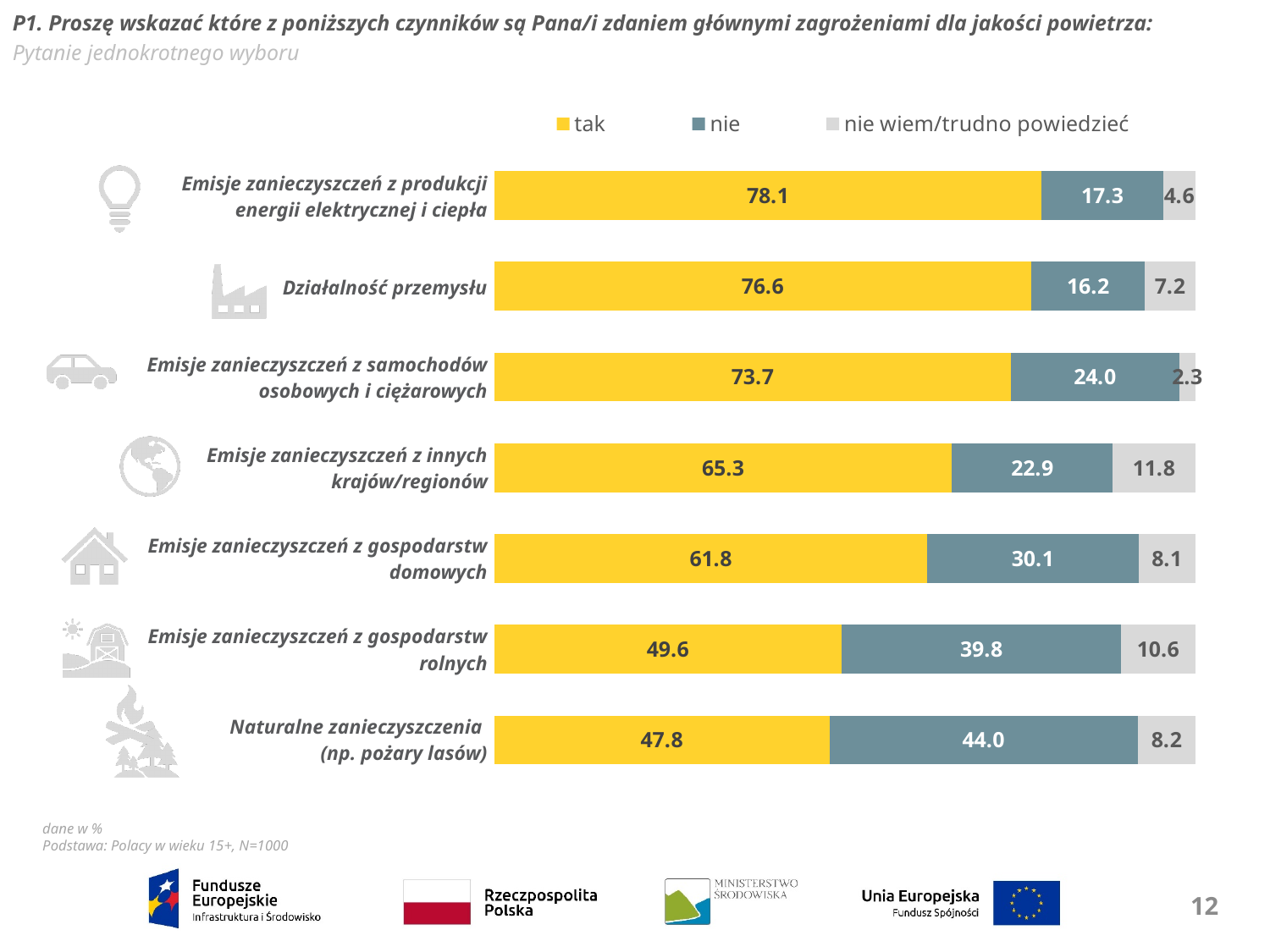
Which category has the lowest 'tak' value? Naturalne zanieczyszczenia (np. pożary lasów) What kind of chart is shown on the slide? Stacked bar chart What is the total of the stacked bar for 'Emisje zanieczyszczeń z gospodarstw rolnych'? 100.0 Which category has the highest 'nie' value? Naturalne zanieczyszczenia (np. pożary lasów) What is the 'tak' value for 'Działalność przemysłu'? 76.6 What is the 'nie' value for 'Emisje zanieczyszczeń z gospodarstw domowych'? 30.1 How many categories are shown in the chart? 7 Which is larger: the 'nie' value for 'Emisje zanieczyszczeń z samochodów osobowych i ciężarowych' or the 'nie' value for 'Emisje zanieczyszczeń z innych krajów/regionów'? Emisje zanieczyszczeń z samochodów osobowych i ciężarowych How many series does the legend list? 3 Which category has the highest 'tak' value? Emisje zanieczyszczeń z produkcji energii elektrycznej i ciepła What is the difference between the 'tak' values for 'Emisje zanieczyszczeń z produkcji energii elektrycznej i ciepła' and 'Naturalne zanieczyszczenia (np. pożary lasów)'? 30.3 What is the 'nie wiem/trudno powiedzieć' value for 'Emisje zanieczyszczeń z innych krajów/regionów'? 11.8